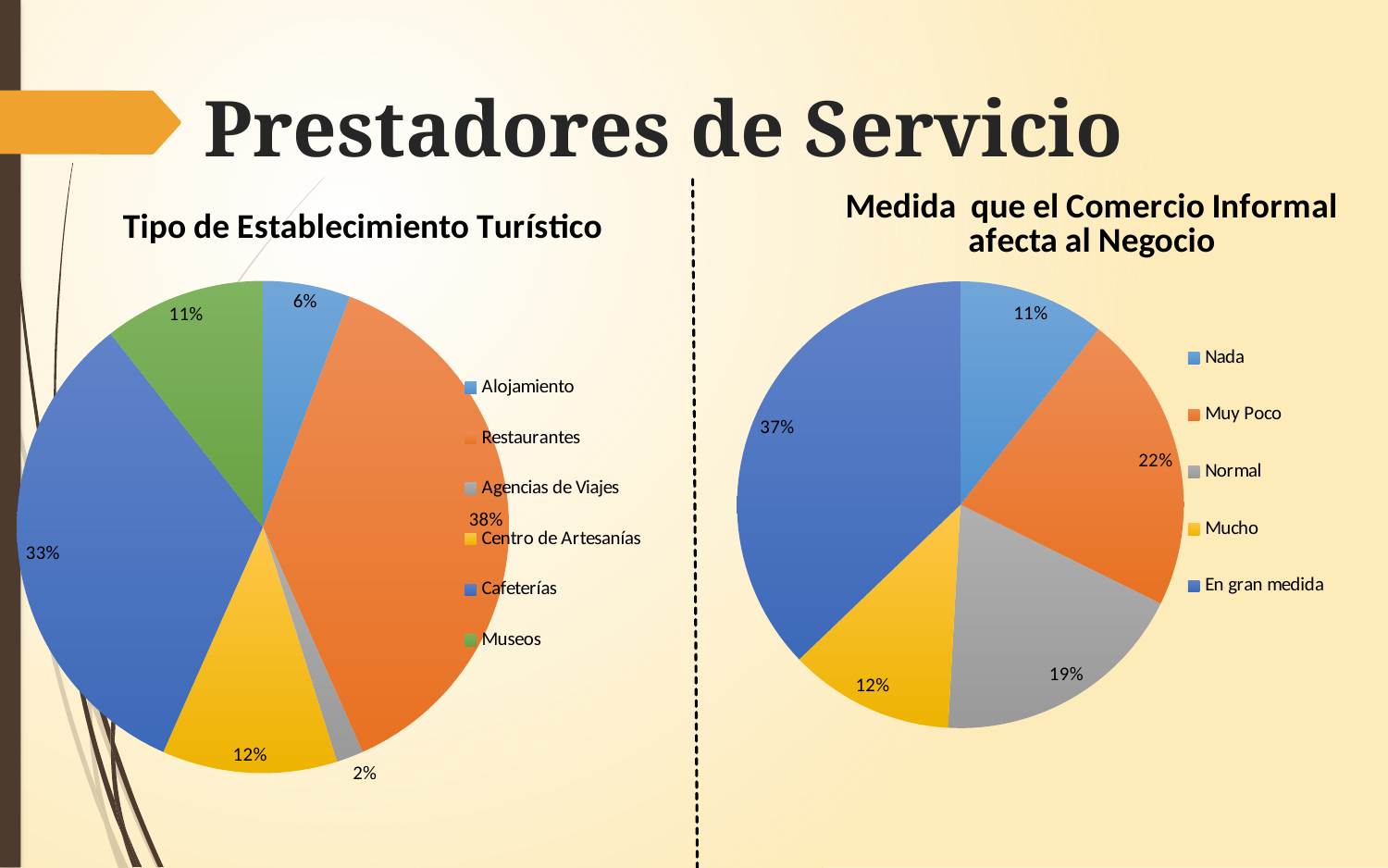
In the 'Medida que el Comercio Informal afecta al Negocio' chart, what colour is the 'Mucho' slice? Yellow What kind of chart is 'Medida que el Comercio Informal afecta al Negocio'? Pie chart In the 'Medida que el Comercio Informal afecta al Negocio' chart, which is larger, 'Muy Poco' or 'Mucho'? Muy Poco In the 'Tipo de Establecimiento Turístico' chart, which category has the largest slice? Restaurantes In the 'Medida que el Comercio Informal afecta al Negocio' chart, what share does 'En gran medida' have? 37% In the 'Tipo de Establecimiento Turístico' chart, which category has the smallest slice? Agencias de Viajes In the 'Medida que el Comercio Informal afecta al Negocio' chart, what share does 'Normal' have? 19% In the 'Tipo de Establecimiento Turístico' chart, how many categories does the legend list? 6 In the 'Tipo de Establecimiento Turístico' chart, what is the difference between the Cafeterías share and the Museos share? 22% In the 'Medida que el Comercio Informal afecta al Negocio' chart, which category has the smallest slice? Nada In the 'Tipo de Establecimiento Turístico' chart, what share does Cafeterías have? 33%